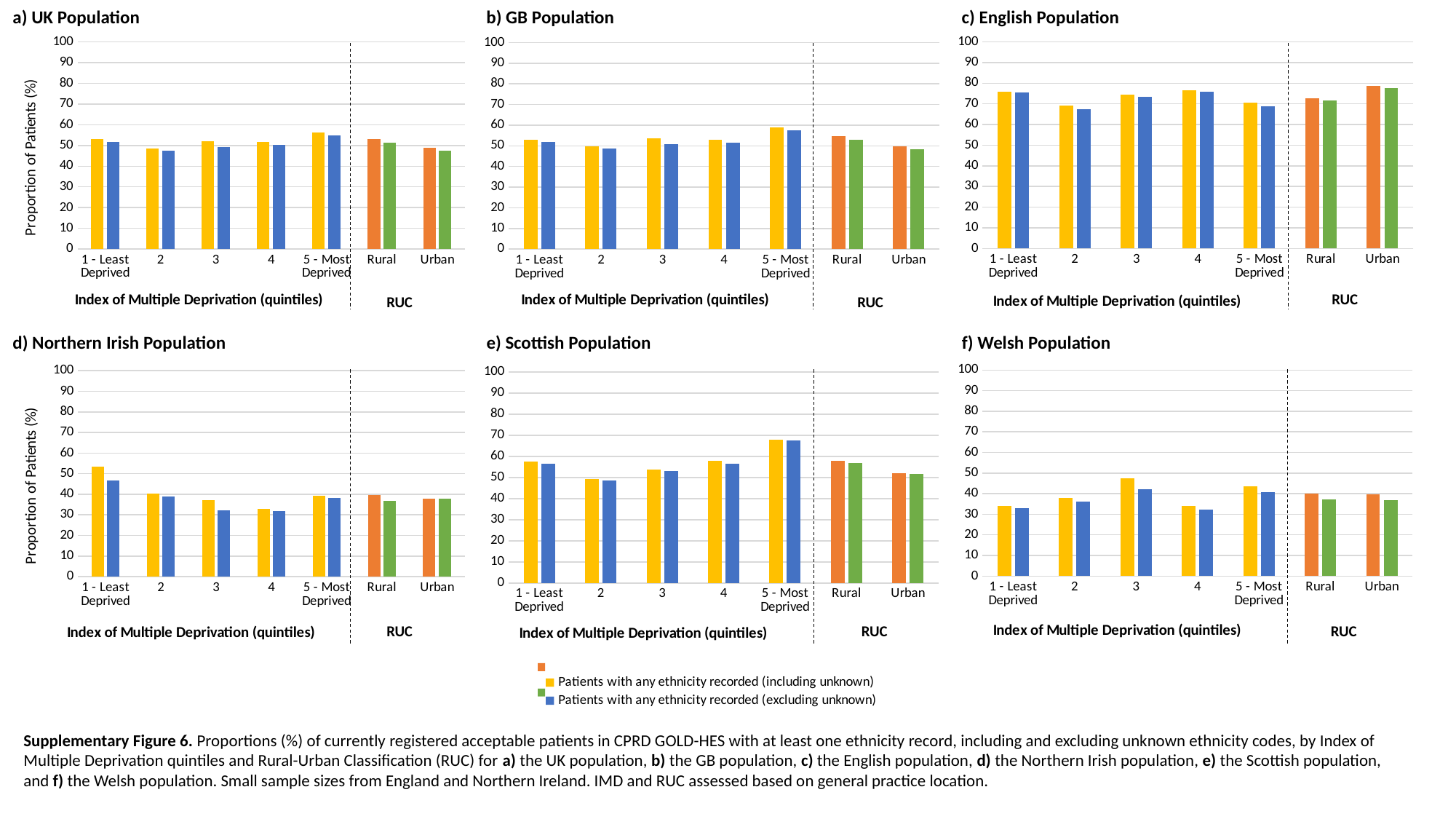
In the f) Welsh Population chart, which category has the highest value for patients with any ethnicity recorded (including unknown)? 3 In the e) Scottish Population chart, is the value for 5 - Most Deprived (including unknown) greater or less than 60? greater In the a) UK Population chart, which is larger for patients with any ethnicity recorded (including unknown): Rural or Urban? Rural In the b) GB Population chart, which category has the highest value for patients with any ethnicity recorded (including unknown)? 5 - Most Deprived How many series does the legend at the bottom of the slide list? 2 In the c) English Population chart, is the value for Urban (including unknown) greater or less than 70? greater In the d) Northern Irish Population chart, do the values for patients with any ethnicity recorded (including unknown) rise or fall from quintile 1 - Least Deprived to quintile 4? fall What kind of chart is used in panel a) UK Population? bar chart In the d) Northern Irish Population chart, which IMD quintile has the lowest value for patients with any ethnicity recorded (including unknown)? 4 What is the label on the y axis of the a) UK Population chart? Proportion of Patients (%) In the d) Northern Irish Population chart, which category has the highest value for patients with any ethnicity recorded (including unknown)? 1 - Least Deprived In the d) Northern Irish Population chart, how many categories are shown on the x axis? 7